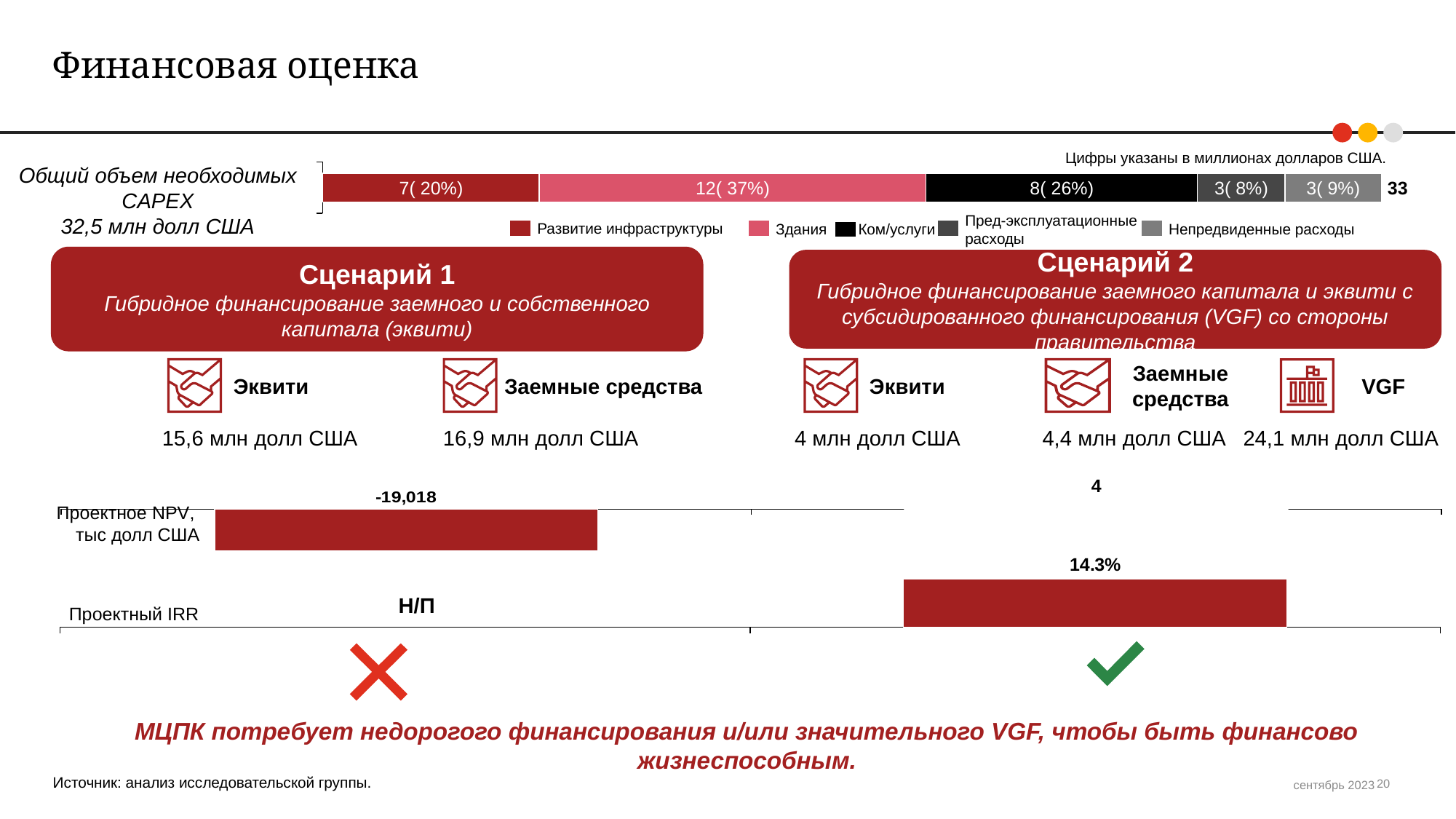
In the stacked bar chart at the top of the slide (CAPEX breakdown), what is the value shown for the 'Здания' segment? 12( 37%) What kind of chart is used at the top of the slide to show the CAPEX breakdown? Stacked bar chart In the stacked bar chart at the top of the slide (CAPEX breakdown), what total is printed at the end of the bar? 33 In the stacked bar chart at the top of the slide (CAPEX breakdown), what is the value shown for the 'Развитие инфраструктуры' segment? 7( 20%) In the stacked bar chart at the top of the slide, which is larger: the 'Ком/услуги' segment or the 'Развитие инфраструктуры' segment? Ком/услуги In the stacked bar chart at the top of the slide, what share of the total does 'Непредвиденные расходы' account for? 9% In the stacked bar chart at the top of the slide (CAPEX breakdown), what is the value shown for the 'Ком/услуги' segment? 8( 26%) In the 'Проектный IRR' chart, what is the value for Сценарий 2? 14.3% In the stacked bar chart at the top of the slide (CAPEX breakdown), which segment is the largest? Здания In the 'Проектное NPV, тыс долл США' chart, what is the value for Сценарий 1? -19,018 In the 'Проектное NPV, тыс долл США' chart, what is the value for Сценарий 2? 4 How many series does the legend of the stacked bar chart at the top of the slide list? 5